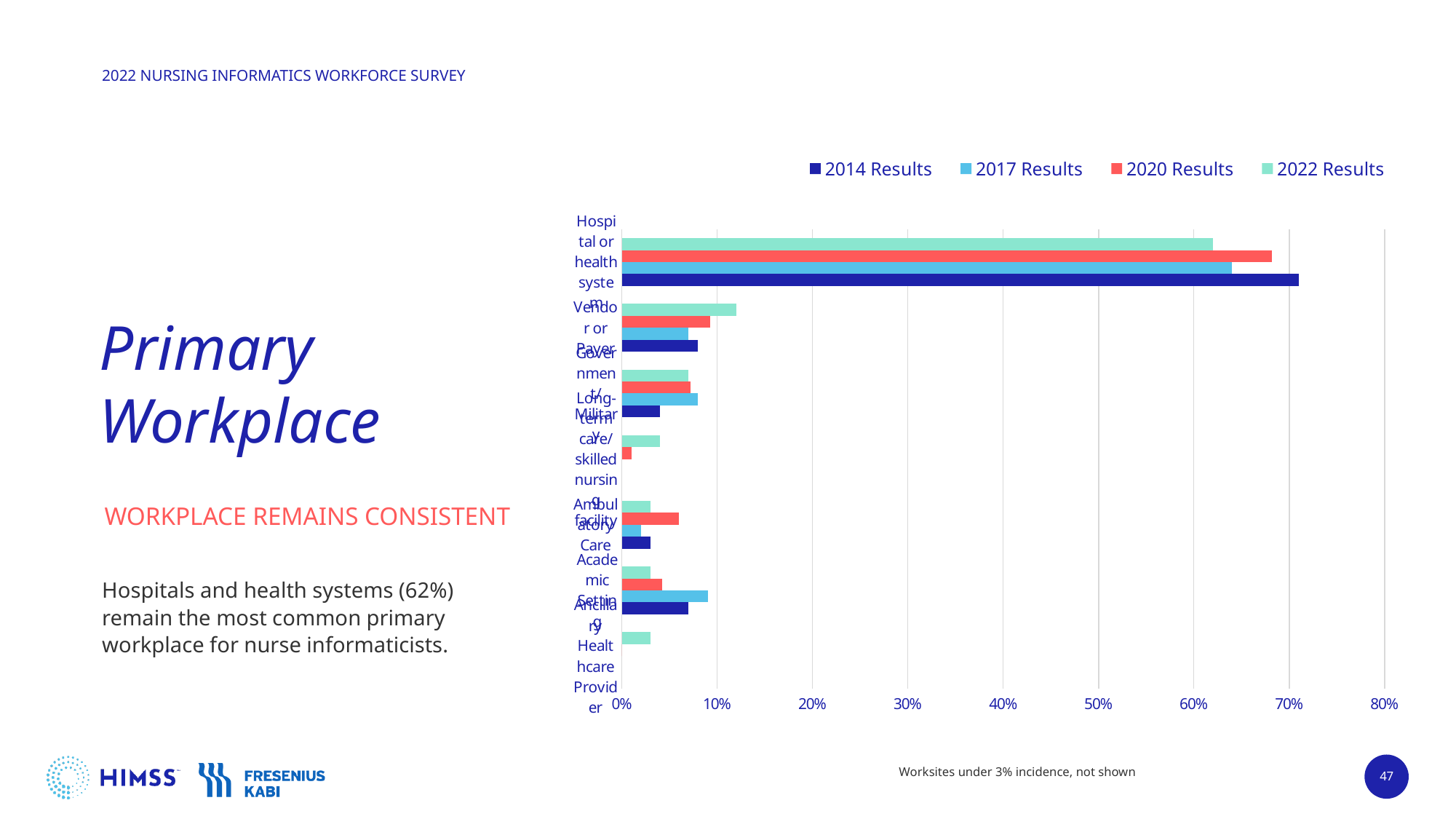
Is the 2022 Results value for Vendor or Payer greater or less than 10%? greater How many series does the chart legend list? 4 Is the 2014 Results value for Government/Military greater or less than 10%? less How many workplace categories are plotted on the chart? 7 For Hospital or health system, which is larger: the 2014 Results value or the 2017 Results value? 2014 Results According to the slide, what share of nurse informaticists reported hospitals and health systems as their primary workplace in 2022? 62% What does the footnote below the chart say about worksites with low incidence? Worksites under 3% incidence, not shown Which workplace category has the highest values across all survey years? Hospital or health system What kind of chart is shown on the slide? bar chart For Academic Setting, which is larger: the 2017 Results value or the 2020 Results value? 2017 Results Is the 2020 Results value for Hospital or health system greater or less than 70%? less